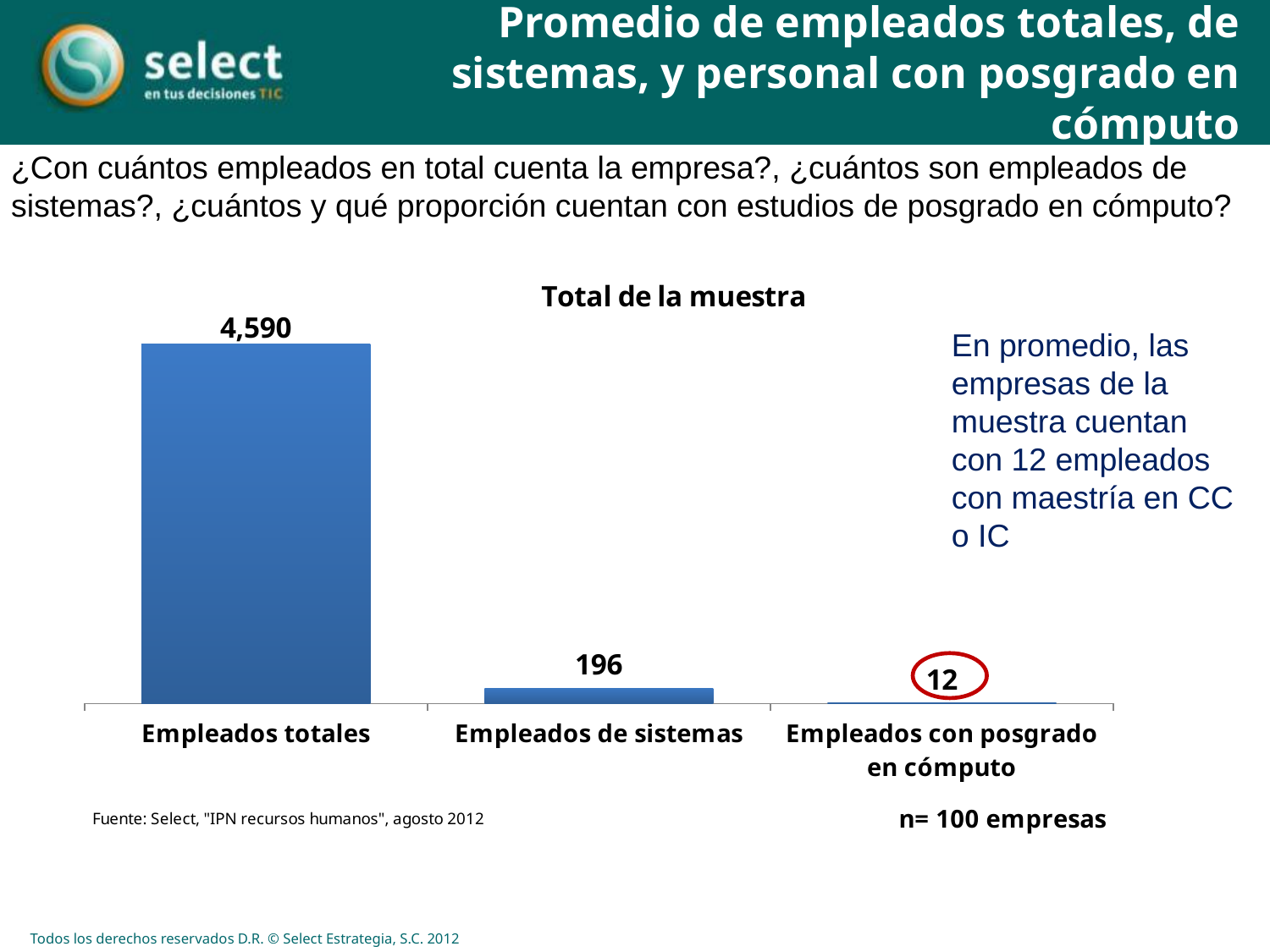
What kind of chart is shown? Bar chart What is the difference between Empleados de sistemas and Empleados con posgrado en cómputo? 184 Which category has the highest value? Empleados totales Which category has the lowest value? Empleados con posgrado en cómputo What is the value for Empleados totales? 4,590 What is the difference between Empleados totales and Empleados de sistemas? 4,394 What is the value for Empleados con posgrado en cómputo? 12 Which is larger, Empleados de sistemas or Empleados con posgrado en cómputo? Empleados de sistemas How many categories are shown in the chart? 3 Do the values rise or fall from left to right along the x axis? Fall What is the value for Empleados de sistemas? 196 What is the title of the chart? Total de la muestra